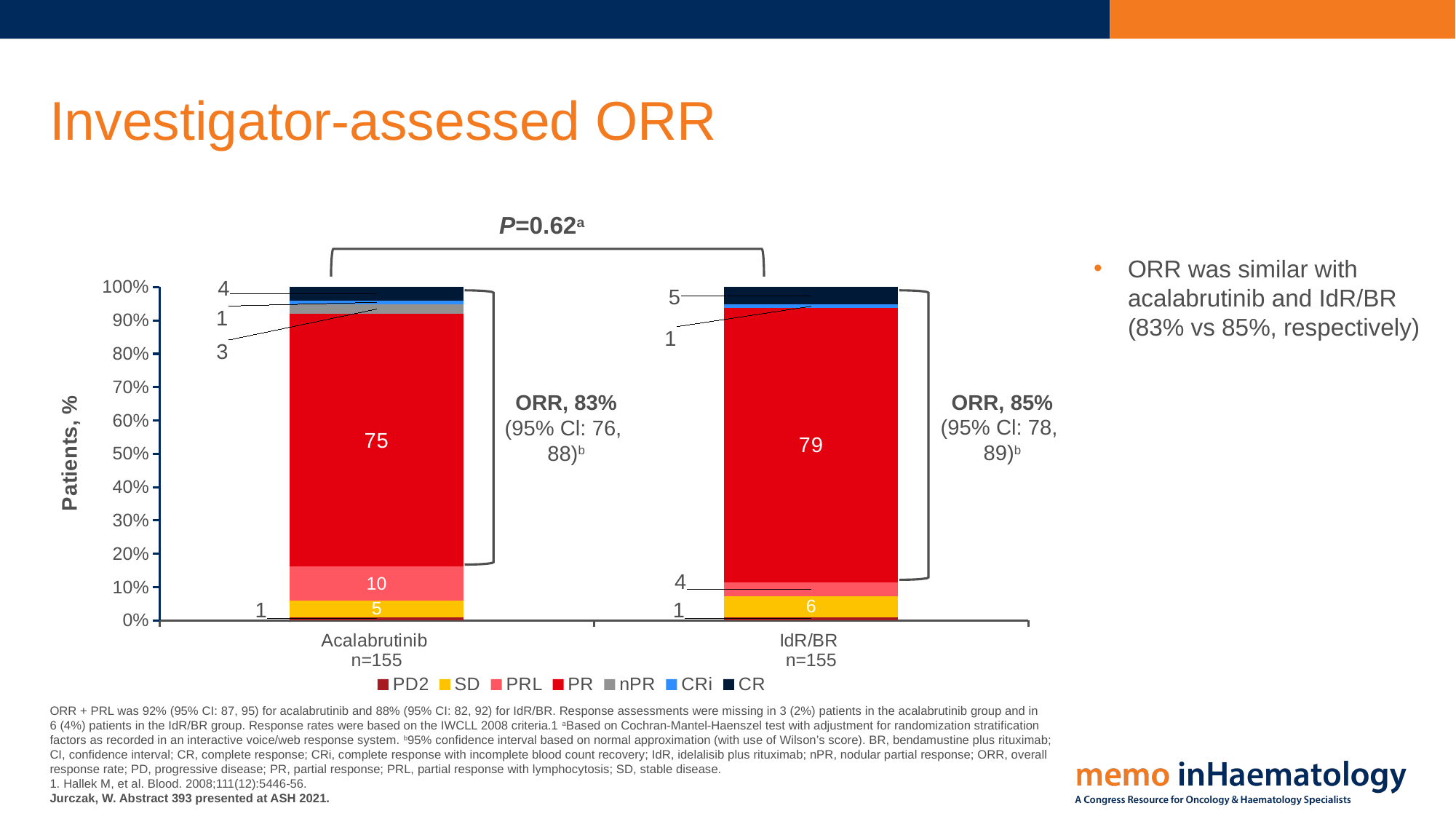
How many treatment groups are shown on the x axis? 2 What kind of chart is shown on the slide? Stacked bar chart How many series does the legend list? 7 Which group has the larger PR value, Acalabrutinib or IdR/BR? IdR/BR What ORR is reported for the Acalabrutinib group? 83% What is the PR value for IdR/BR? 79 What is the SD value for Acalabrutinib? 5 What is the PR value for Acalabrutinib? 75 What is the difference between the PR values for IdR/BR and Acalabrutinib? 4 What is the SD value for IdR/BR? 6 What is the PRL value for Acalabrutinib? 10 What is the CR value for IdR/BR? 5